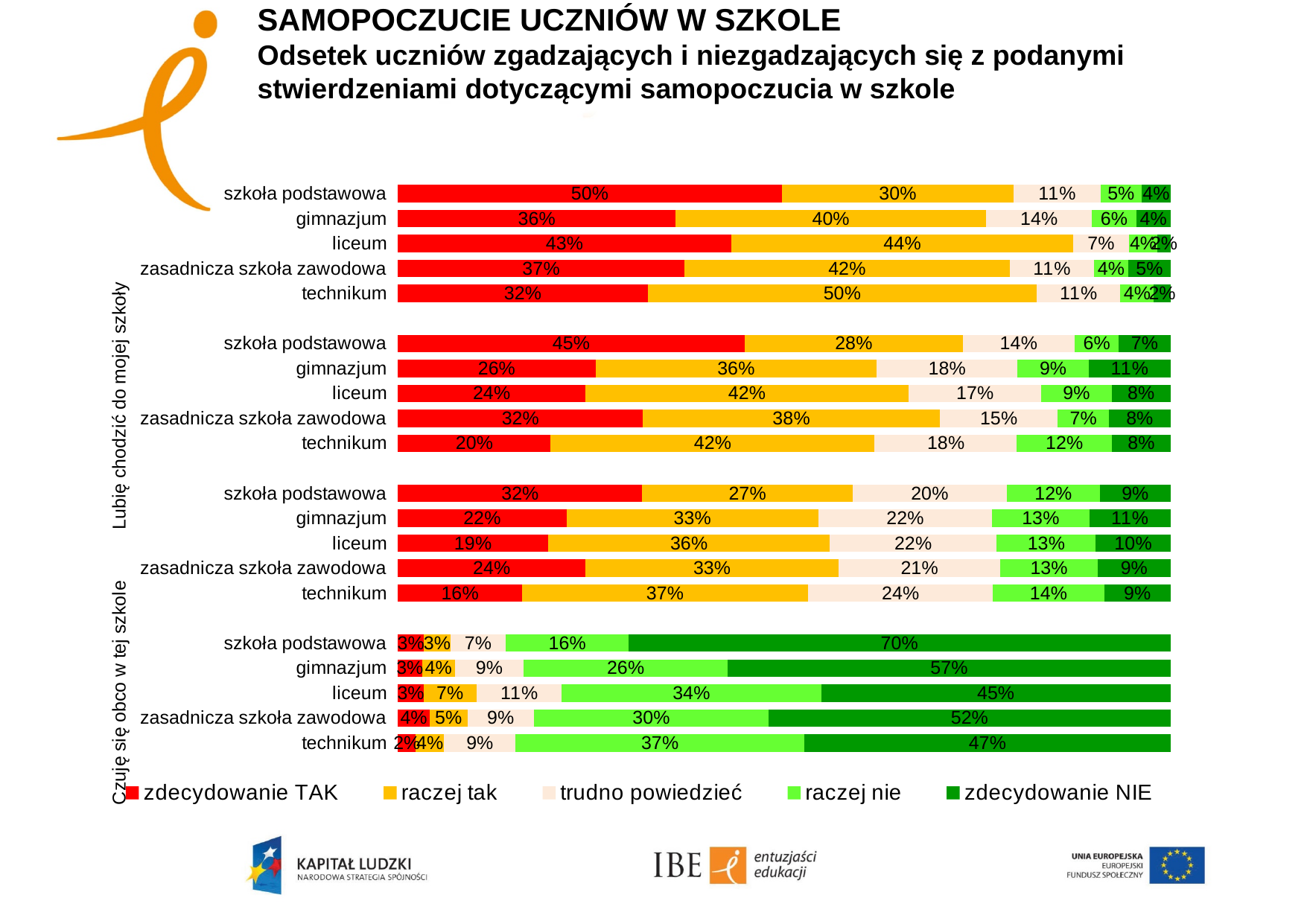
In the bottom group ('Czuję się obco w tej szkole'), which school type has the lowest 'zdecydowanie NIE' value? liceum Which legend entry is shown in red? zdecydowanie TAK How many school types are shown in each group of bars? 5 In the bottom group ('Czuję się obco w tej szkole'), what is the 'raczej nie' value for liceum? 34% In the bottom group ('Czuję się obco w tej szkole'), which school type has the highest 'zdecydowanie NIE' value? szkoła podstawowa What kind of chart is shown on the slide? bar chart How many series does the legend list? 5 In the top group of bars, what is the 'zdecydowanie TAK' value for szkoła podstawowa? 50% In the top group of bars, how much higher is the 'zdecydowanie TAK' value for szkoła podstawowa than for gimnazjum? 14 percentage points In the bottom group ('Czuję się obco w tej szkole'), what is the 'zdecydowanie NIE' value for szkoła podstawowa? 70% In the third group of bars from the top, which has the larger 'trudno powiedzieć' value: technikum or szkoła podstawowa? technikum In the second group of bars from the top, what is the 'raczej nie' value for technikum? 12%